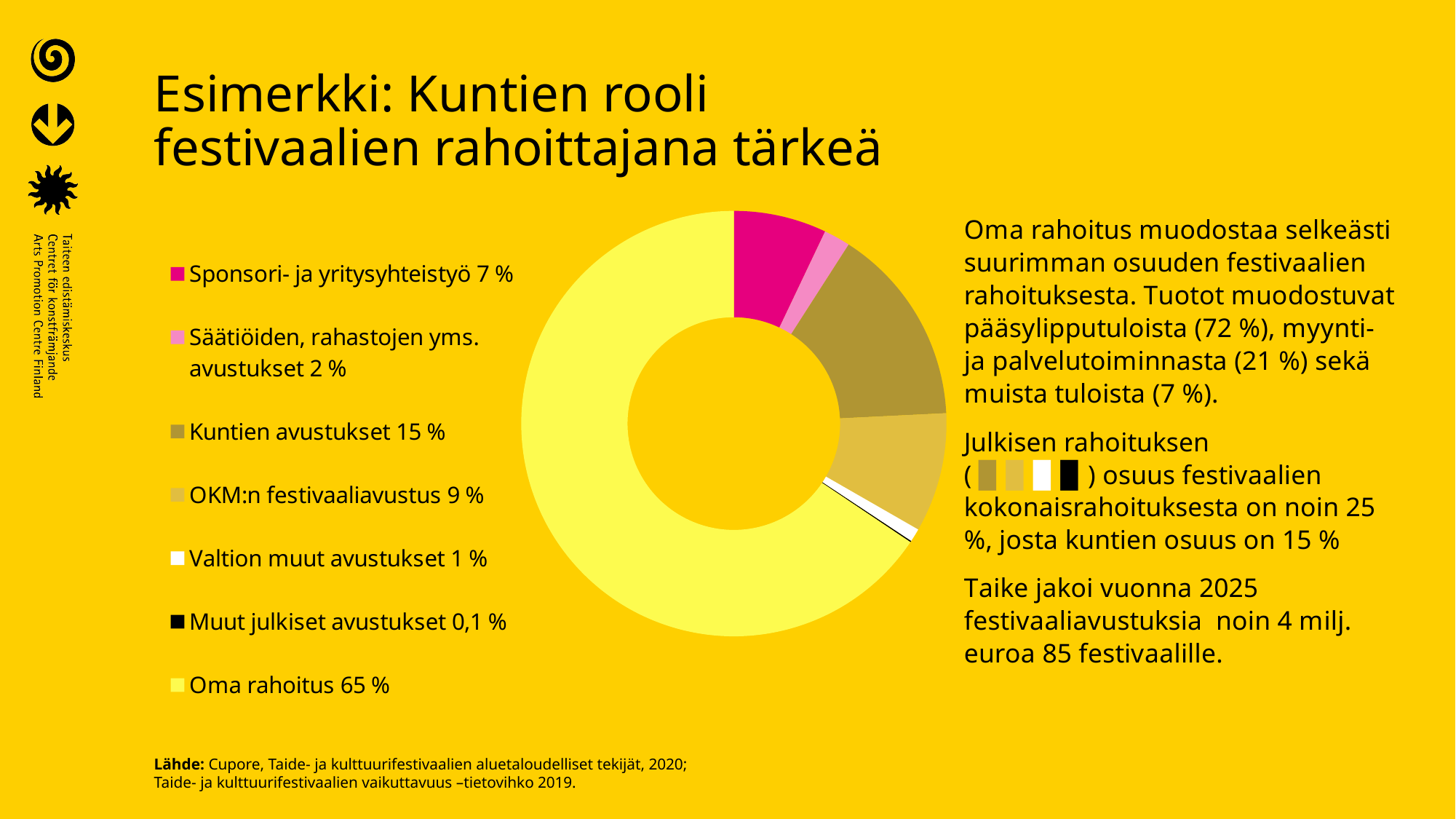
What is the value for 'Kuntien avustukset'? 15 % Which is larger: 'Sponsori- ja yritysyhteistyö' or 'Säätiöiden, rahastojen yms. avustukset'? Sponsori- ja yritysyhteistyö What is the value for 'Muut julkiset avustukset'? 0,1 % What share of festival funding is 'Oma rahoitus'? 65 % How many categories does the pie chart's legend list? 7 What kind of chart is shown on the slide? Pie (donut) chart What colour is the 'Sponsori- ja yritysyhteistyö' slice in the pie chart? Magenta (pink) What is the value for 'OKM:n festivaaliavustus'? 9 % What is the combined share of 'Kuntien avustukset' and 'OKM:n festivaaliavustus'? 24 % Which category has the smallest share of the pie? Muut julkiset avustukset Which category has the largest share of the pie? Oma rahoitus What is the difference between 'Kuntien avustukset' and 'OKM:n festivaaliavustus'? 6 %